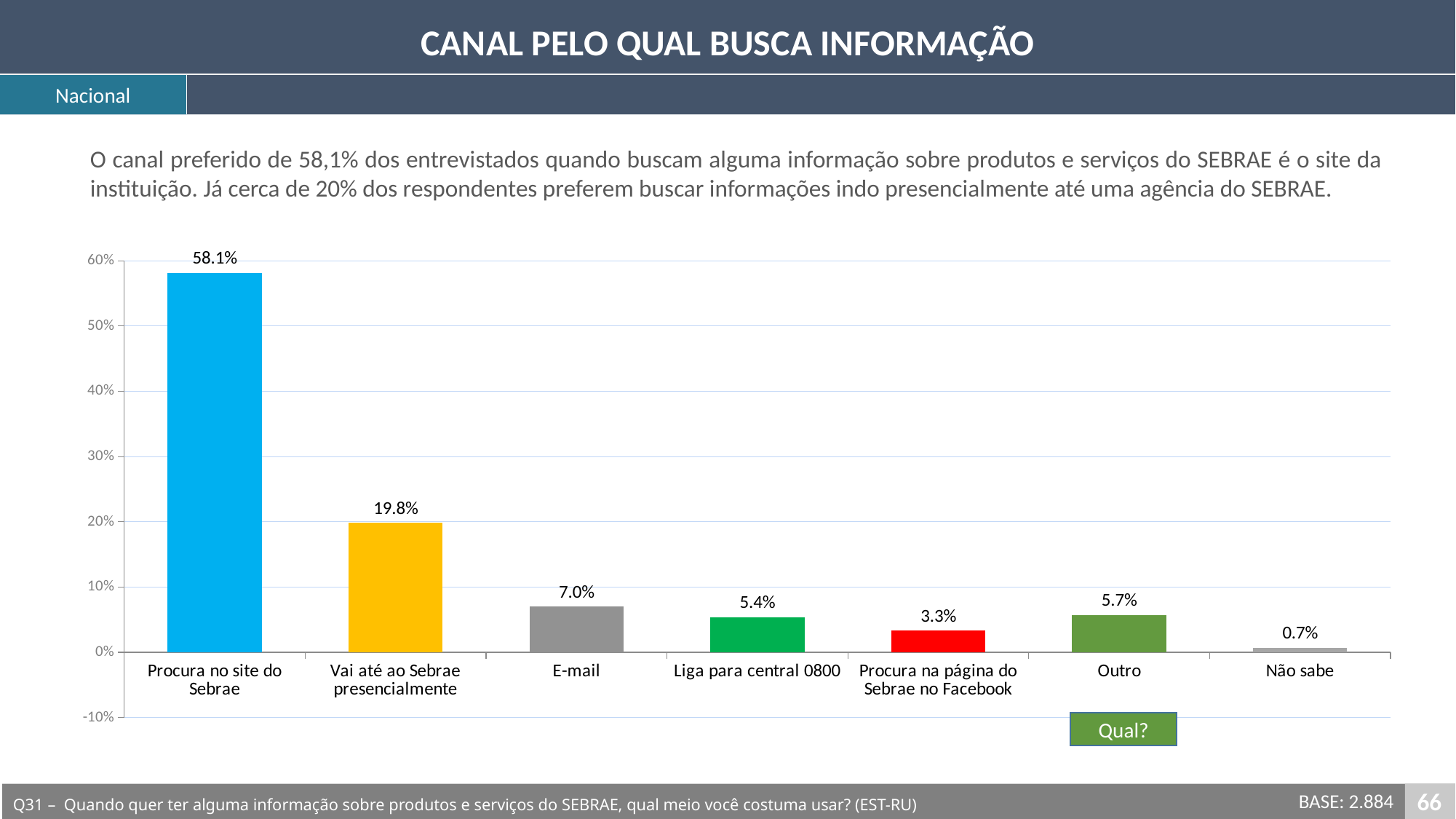
Which category has the highest value? Procura no site do Sebrae What is the value for 'Vai até ao Sebrae presencialmente'? 19.8% What is the value for 'Procura na página do Sebrae no Facebook'? 3.3% What is the value for 'E-mail'? 7.0% Is the value for 'E-mail' greater or less than 10%? less Which category has the lowest value? Não sabe How many categories are shown in the chart? 7 What is the difference between 'Procura no site do Sebrae' and 'Vai até ao Sebrae presencialmente'? 38.3% What kind of chart is shown on the slide? bar chart What is the value for 'Procura no site do Sebrae'? 58.1% What is the title of the slide? CANAL PELO QUAL BUSCA INFORMAÇÃO Which is larger, 'Liga para central 0800' or 'Outro'? Outro